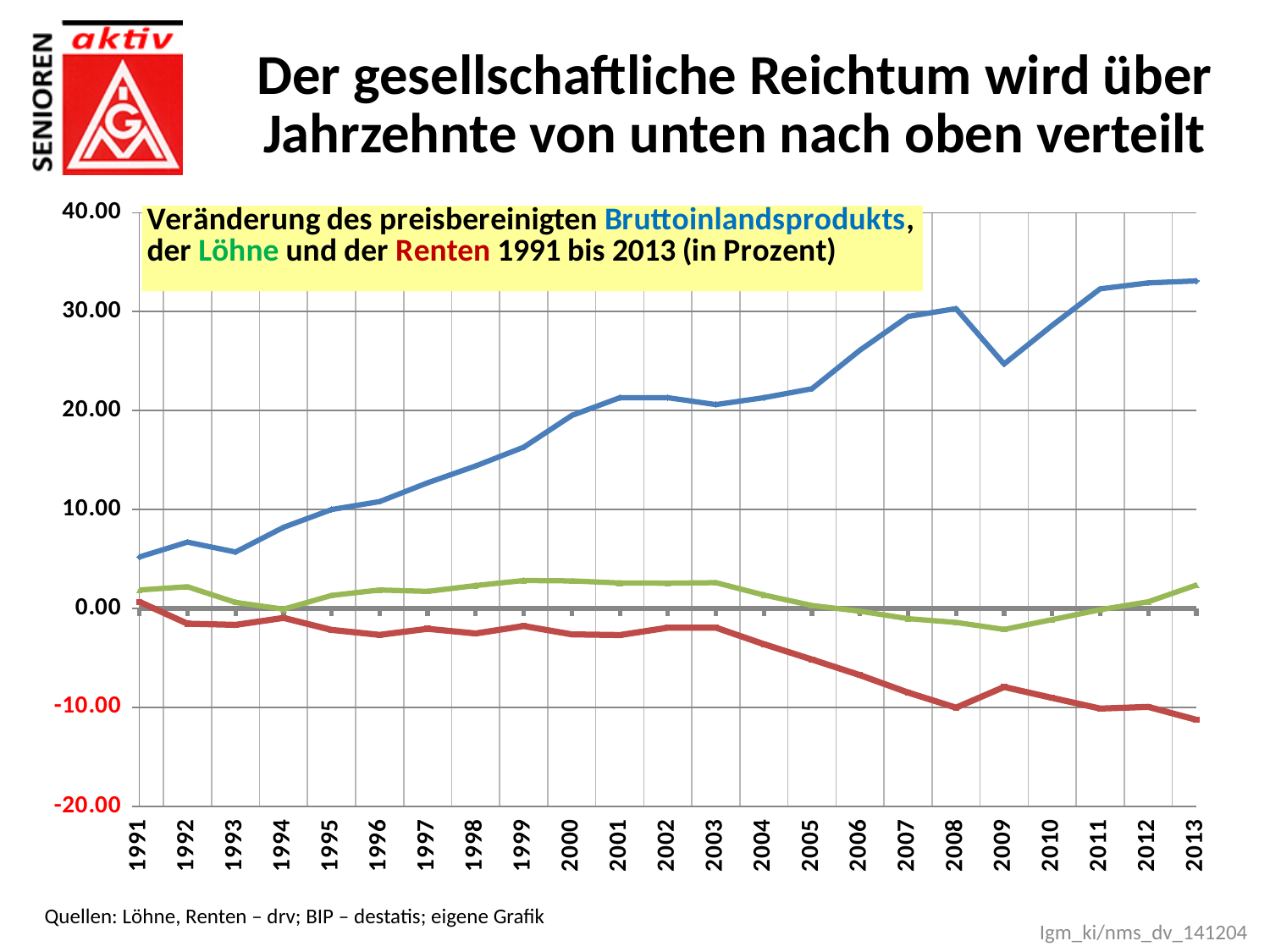
How many data series does the chart show? 3 Which series has the lowest value in 2008? Renten Is the value for Renten in 2013 greater or less than -10.00? less Is the value for Löhne in 2009 greater or less than 0.00? less Which series is shown in blue on the chart? Bruttoinlandsprodukt Is the value for Bruttoinlandsprodukt in 2001 greater or less than 20.00? greater Which series has the highest value in 2013? Bruttoinlandsprodukt Does the Renten series generally rise or fall from 1991 to 2013? fall What kind of chart is shown on the slide? line chart Which series is shown in red on the chart? Renten How many years are plotted along the x axis of the chart? 23